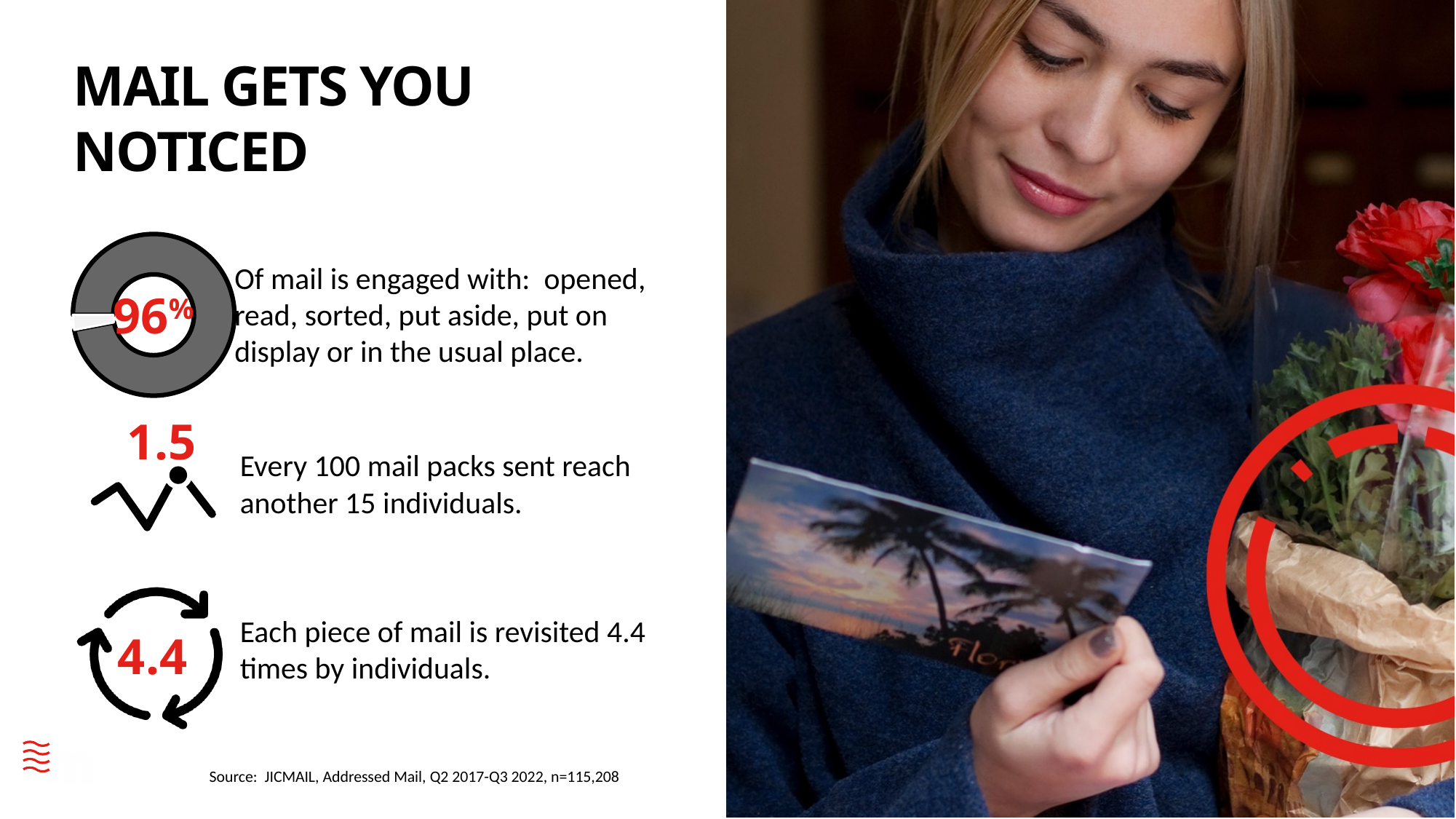
What kind of chart is shown on the left of the slide next to the text about mail being engaged with? Donut (pie) chart According to the text beside the donut chart, what does the 96% figure represent? Mail that is engaged with: opened, read, sorted, put aside, put on display or in the usual place What is the title of the slide containing the donut chart? MAIL GETS YOU NOTICED Is the share shown by the grey segment of the donut chart greater or less than 50%? greater What colour is the large segment of the donut chart? Grey How many segments does the donut chart have? 2 Is the share shown by the small white segment of the donut chart greater or less than 25%? less What percentage is printed in the centre of the donut chart? 96% Which segment of the donut chart is larger, the grey one or the white one? The grey one What share of the donut chart does the large grey segment represent? 96%